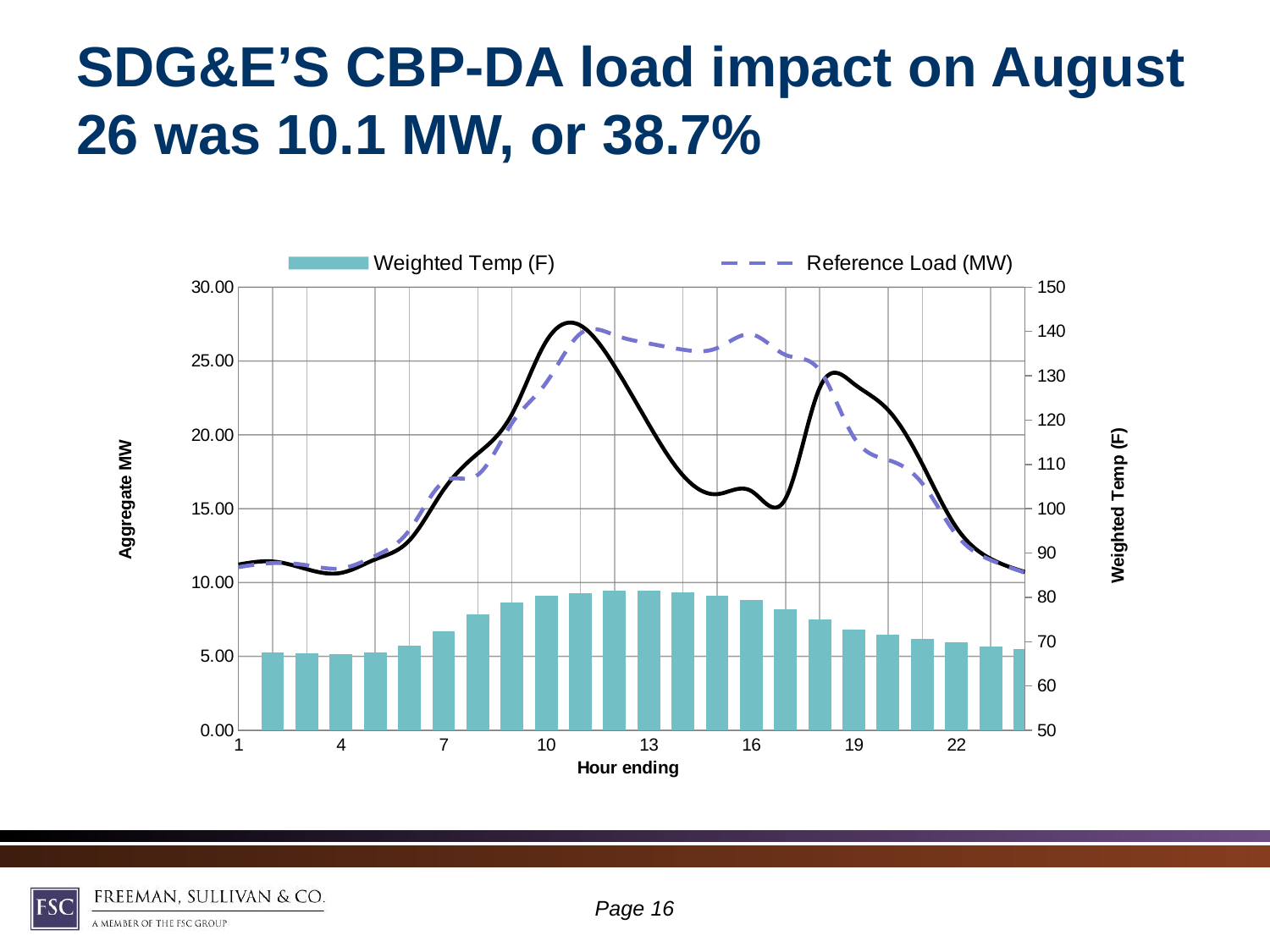
Do the Weighted Temp (F) bars rise or fall from hour ending 13 to hour ending 24? Fall Is the Weighted Temp (F) value at hour ending 4 greater or less than 70? less Is the Weighted Temp (F) value at hour ending 13 greater or less than 70? greater What is the title of the x axis? Hour ending Does the Reference Load (MW) rise or fall between hour ending 1 and hour ending 11? Rise What is the title of the right-hand y axis? Weighted Temp (F) Is the Reference Load (MW) value at hour ending 1 greater or less than 15? less How many series does the chart legend list? 2 Which is larger, the Reference Load (MW) at hour ending 11 or at hour ending 19? Hour ending 11 What kind of chart is shown on the slide? A combination bar and line chart